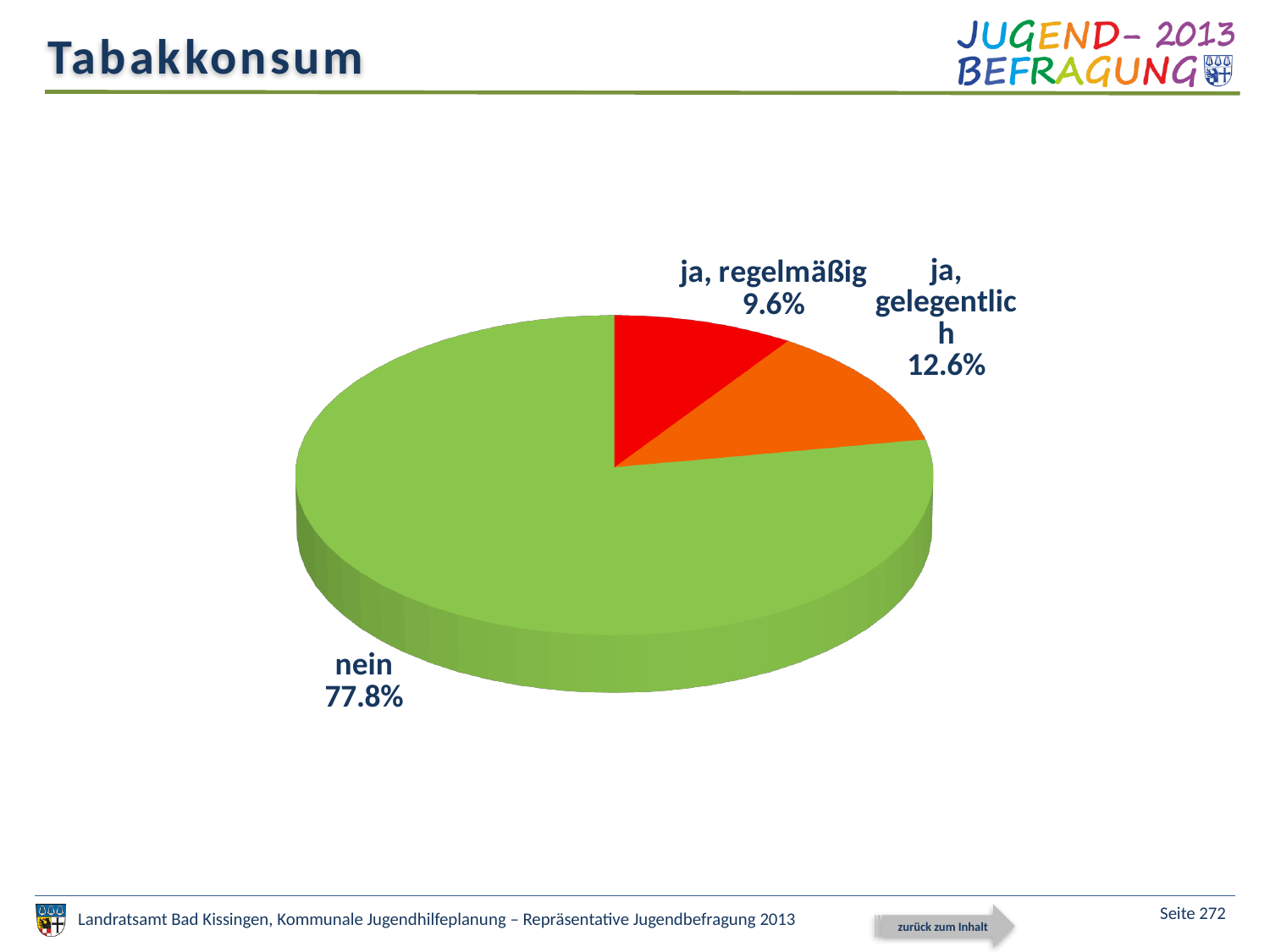
Which slice of the pie is the largest? nein What share of the pie is labelled "ja, gelegentlich"? 12.6% How many slices does the pie chart have? 3 What is the combined share of the two "ja" slices ("ja, regelmäßig" and "ja, gelegentlich")? 22.2% Which slice of the pie is the smallest? ja, regelmäßig What is the difference in percentage points between the "nein" slice and the "ja, gelegentlich" slice? 65.2 What colour is the "nein" slice of the pie? green Which is larger, the share for "ja, gelegentlich" or the share for "ja, regelmäßig"? ja, gelegentlich What share of the pie is labelled "ja, regelmäßig"? 9.6% What share of the pie is labelled "nein"? 77.8% What kind of chart is shown on the slide? pie chart What is the difference in percentage points between the "ja, gelegentlich" slice and the "ja, regelmäßig" slice? 3.0